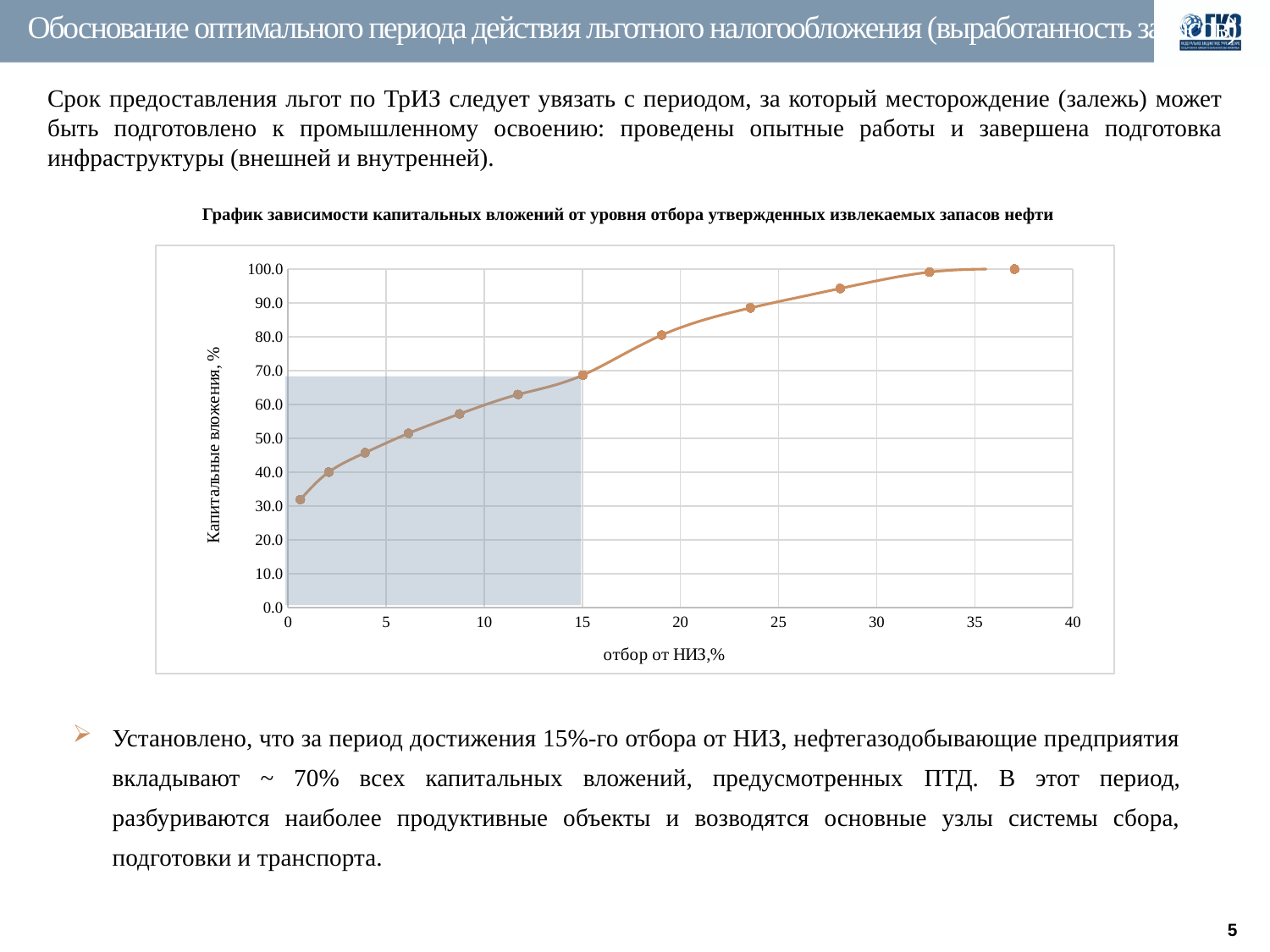
Is the value of capital investments at about 4% отбор от НИЗ greater or less than 50? less Is the value of capital investments at the first plotted point (near 0% отбор от НИЗ) greater or less than 30? greater What is the title of the chart? График зависимости капитальных вложений от уровня отбора утвержденных извлекаемых запасов нефти Is the value of capital investments at about 11.5% отбор от НИЗ greater or less than 60? greater Do the values of capital investments rise or fall as the x-axis value (отбор от НИЗ, %) increases? rise What is the highest tick value shown on the vertical axis of the chart? 100.0 How many data points are plotted on the chart? 12 What kind of chart is shown on the slide? line chart What is the label of the vertical axis of the chart? Капитальные вложения, %